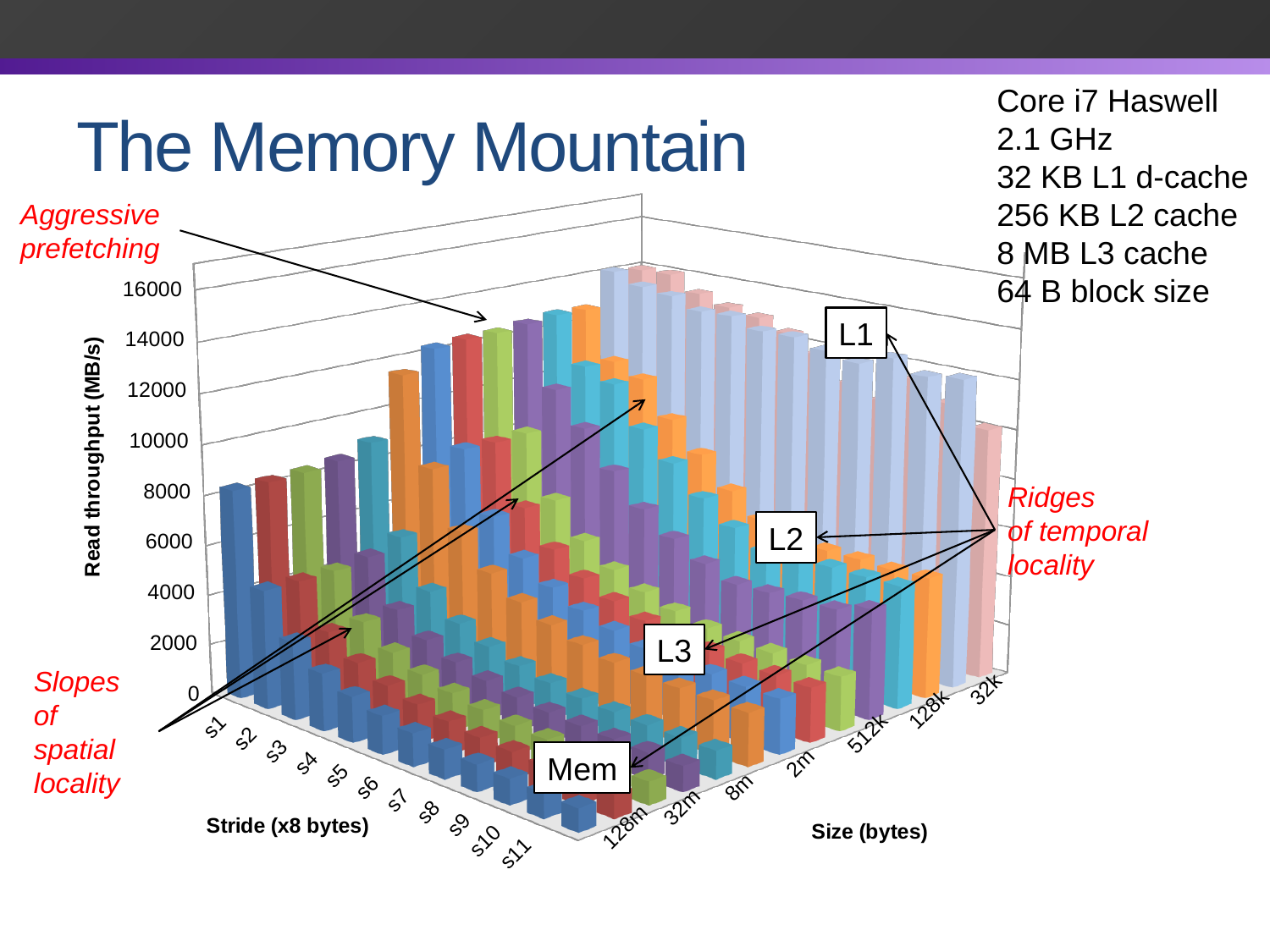
What is the highest tick value shown on the Read throughput (MB/s) axis? 16000 What is the title of the chart on the slide? The Memory Mountain How many size categories are shown along the Size (bytes) axis? 14 Does read throughput rise or fall as the stride increases from s1 to s11? fall Does read throughput rise or fall as the size decreases from 128m toward 32k? rise Which size category has the highest read throughput overall? 32k Which stride category has the highest read throughput for a given size? s1 What kind of chart is shown on the slide? bar chart How many stride categories are shown along the Stride (x8 bytes) axis? 11